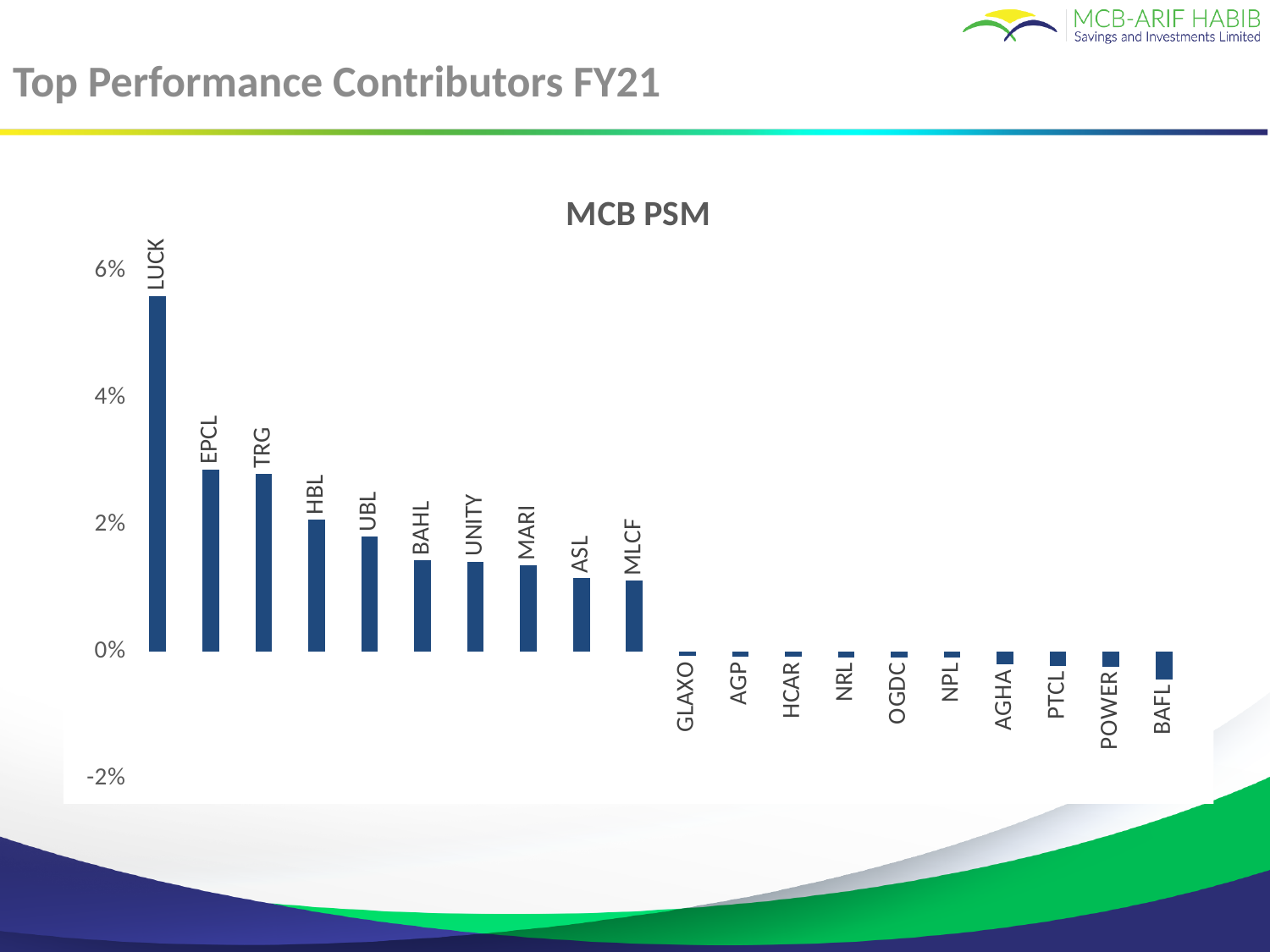
How many categories are plotted in the chart? 20 Is the value for BAHL greater or less than 2%? less What kind of chart is shown on the slide? bar chart What is the title of the chart? MCB PSM Is the value for EPCL greater or less than 2%? greater Do the values rise or fall moving from left to right along the x axis? fall Is the value for LUCK greater or less than 4%? greater Which has a larger value, HBL or BAHL? HBL Which category has the lowest value? BAFL Which has a larger value, LUCK or EPCL? LUCK Which category has the highest value? LUCK